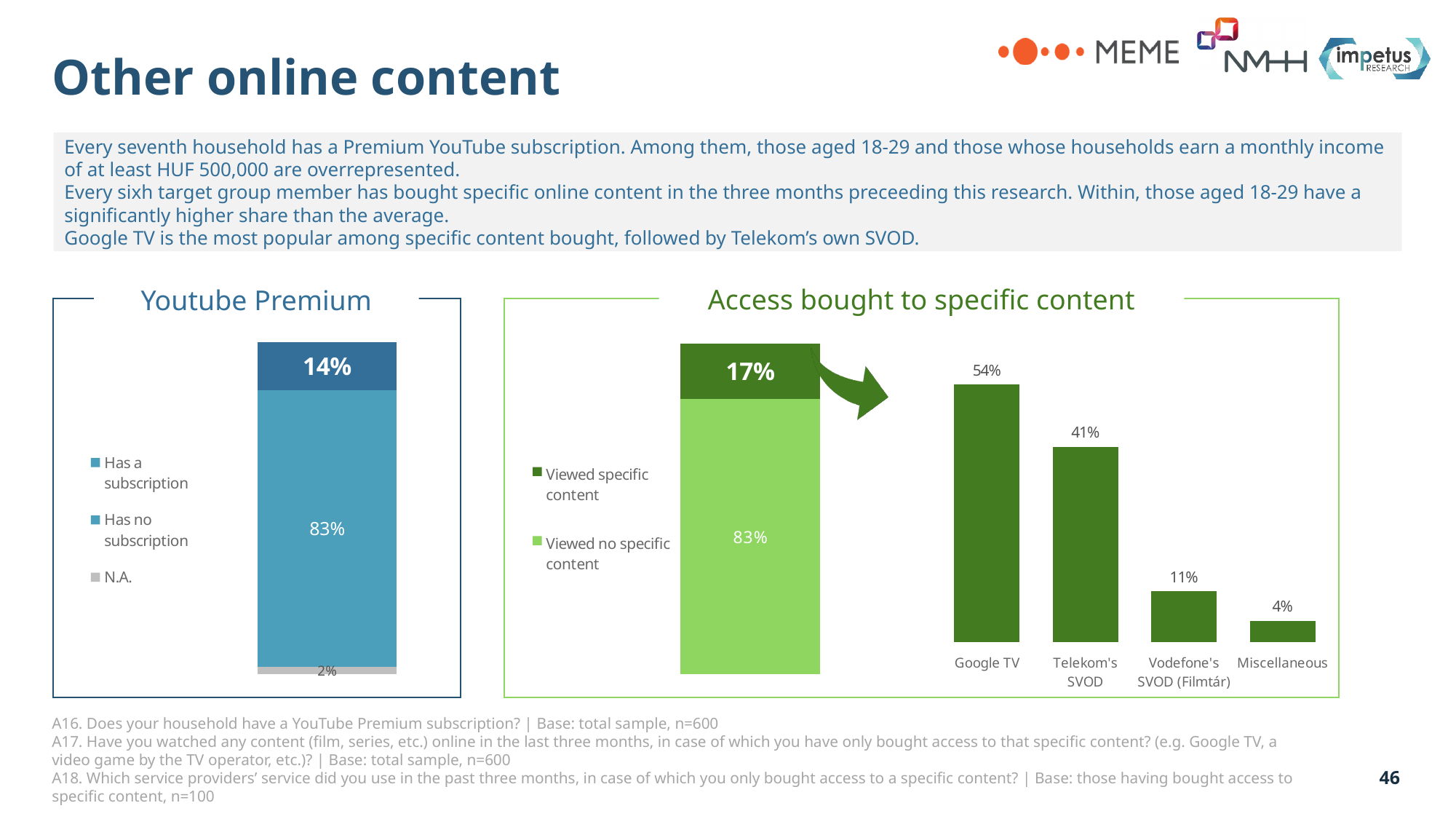
In the Youtube Premium chart, what percentage has no subscription? 83% How many providers are shown in the bar chart on the right of the Access bought to specific content section? 4 In the Youtube Premium chart, what percentage of households has a subscription? 14% In the Youtube Premium chart, what is the value for N.A.? 2% In the provider bar chart on the right, which provider has the lowest value? Miscellaneous In the provider bar chart on the right of the Access bought to specific content section, what is the value for Google TV? 54% In the Access bought to specific content stacked bar, what is the difference between the share that viewed no specific content and the share that viewed specific content? 66% In the Access bought to specific content stacked bar, what share viewed specific content? 17% In the provider bar chart on the right, which provider has the highest value? Google TV How many entries does the legend of the Youtube Premium chart list? 3 In the provider bar chart on the right, what is the difference between Google TV and Telekom's SVOD? 13% In the Access bought to specific content stacked bar, what share viewed no specific content? 83%